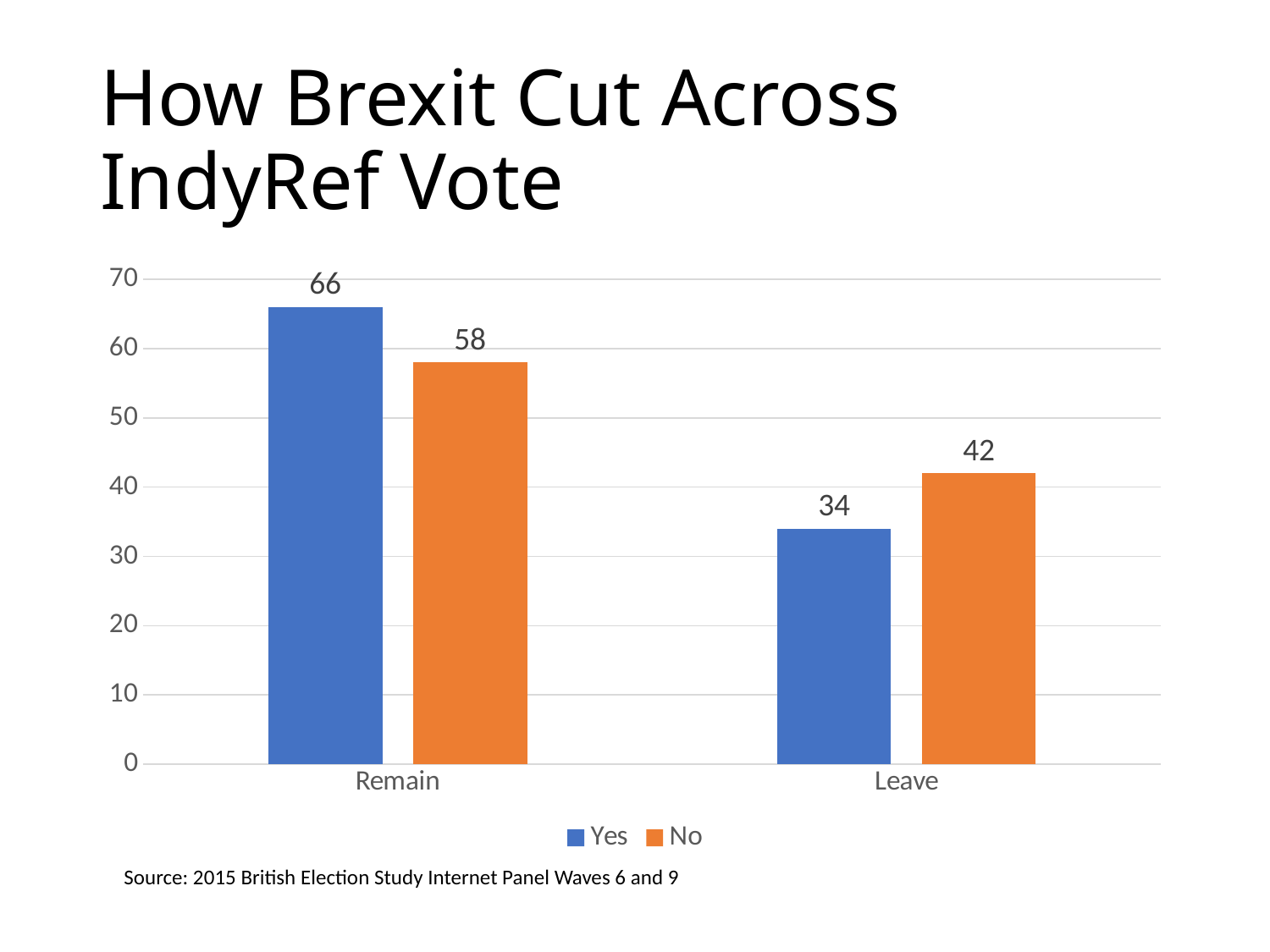
How many categories are shown on the x axis? 2 In the Leave category, which series has the larger value, Yes or No? No Which bar has the lowest value on the chart? Yes, Leave What colour represents the No series? Orange What is the value for No in the Leave category? 42 What kind of chart is shown on the slide? Bar chart How many series does the legend list? 2 What is the difference between the Yes and No values in the Remain category? 8 What is the difference between the No values for Remain and Leave? 16 Which bar has the highest value on the chart? Yes, Remain What is the value for Yes in the Remain category? 66 What is the value for Yes in the Leave category? 34